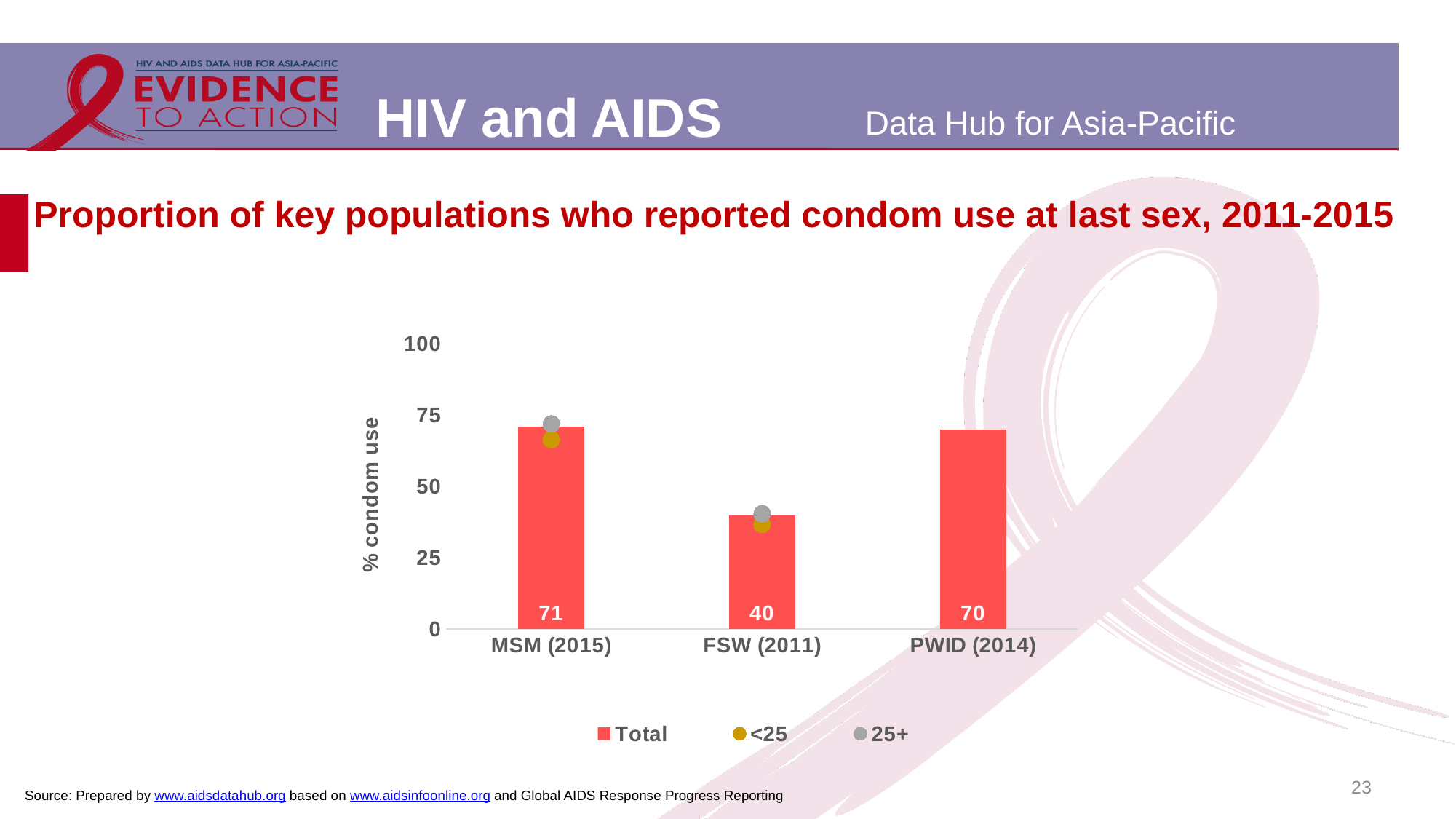
Is the <25 value for FSW (2011) greater or less than 50? less Which key population has the highest Total proportion reporting condom use at last sex? MSM (2015) What is the Total value for FSW (2011)? 40 What is the Total value for MSM (2015)? 71 How many key population categories are shown on the x axis? 3 What is the Total value for PWID (2014)? 70 Is the 25+ value for MSM (2015) greater or less than 50? greater Which has a larger Total value, FSW (2011) or PWID (2014)? PWID (2014) Which key population has the lowest Total proportion reporting condom use at last sex? FSW (2011) What is the difference between the Total values for PWID (2014) and FSW (2011)? 30 What is the difference between the Total values for MSM (2015) and FSW (2011)? 31 How many series does the legend list? 3